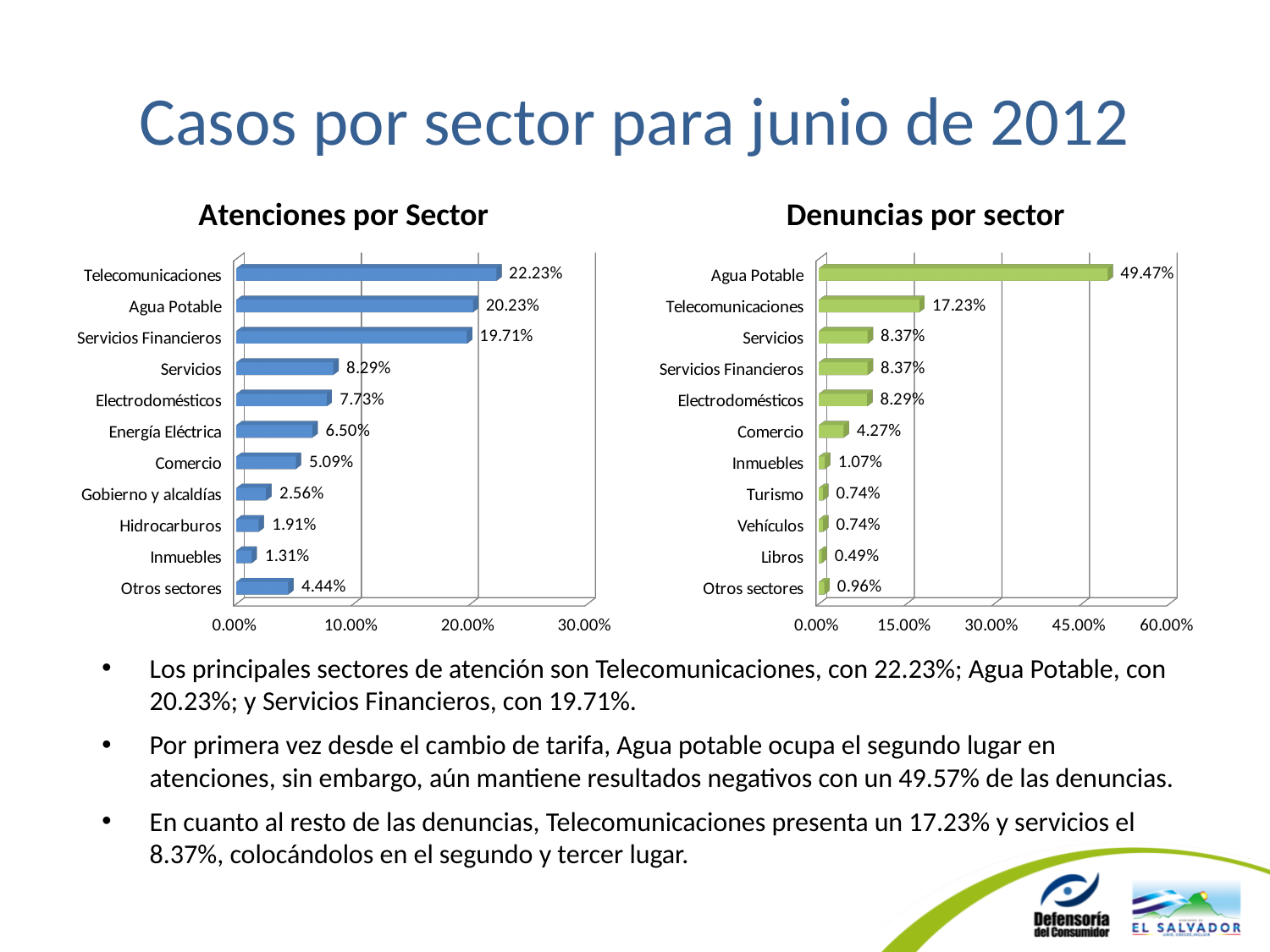
In the 'Denuncias por sector' chart, what is the value for Libros? 0.49% In the 'Atenciones por Sector' chart, which sector has the lowest value? Inmuebles In the 'Denuncias por sector' chart, which sector has the lowest value? Libros What kind of chart is 'Atenciones por Sector'? Bar chart In the 'Atenciones por Sector' chart, which sector has the highest value? Telecomunicaciones What colour are the bars in the 'Denuncias por sector' chart? Green In the 'Denuncias por sector' chart, what is the value for Agua Potable? 49.47% How many sectors are shown in the 'Denuncias por sector' chart? 11 In the 'Atenciones por Sector' chart, what is the value for Telecomunicaciones? 22.23% In the 'Atenciones por Sector' chart, which is larger, Comercio or Otros sectores? Comercio In the 'Denuncias por sector' chart, what is the difference between Agua Potable and Telecomunicaciones? 32.24% In the 'Atenciones por Sector' chart, what is the value for Energía Eléctrica? 6.50%